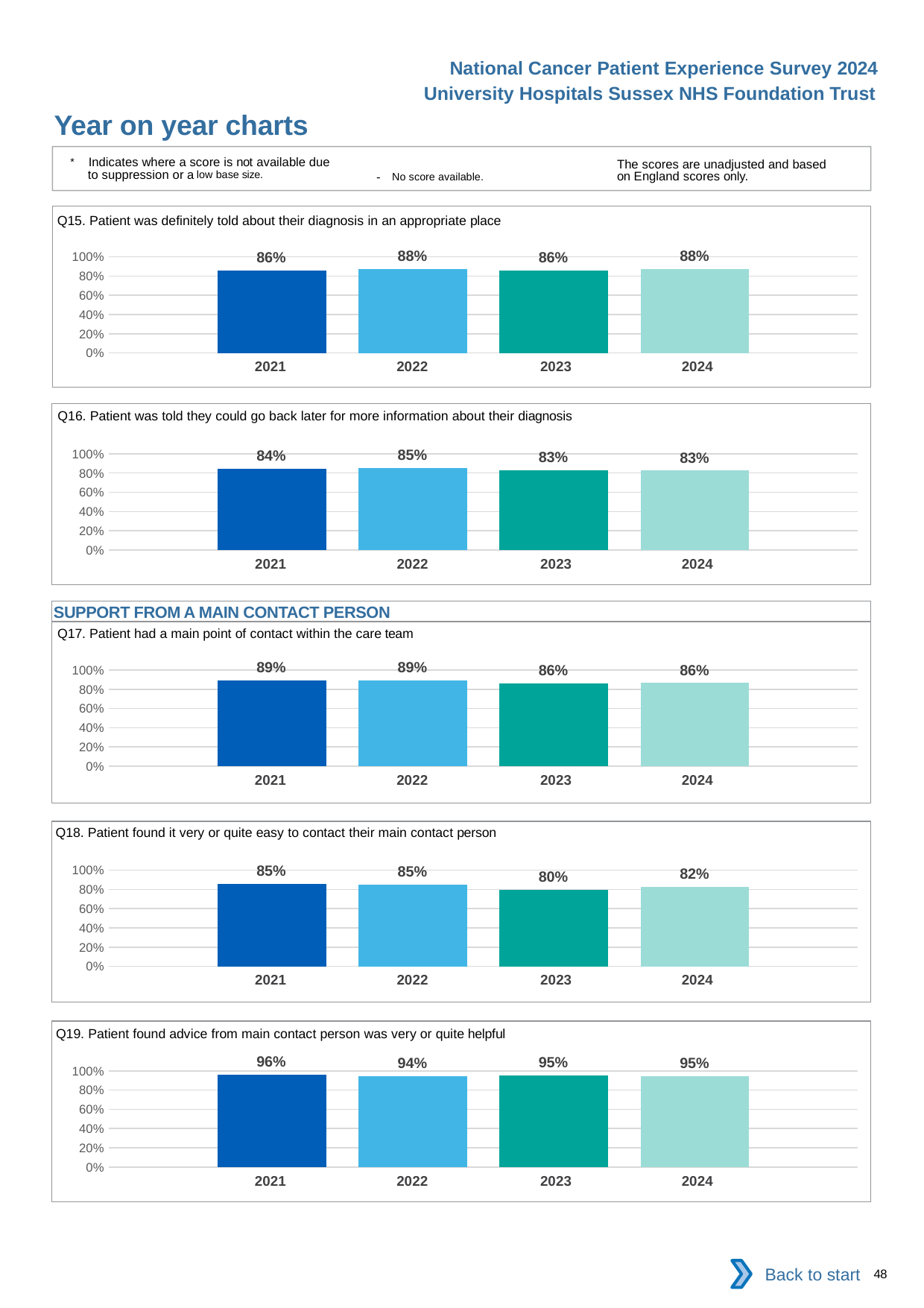
In the Q19 chart, which is larger, the value for 2022 or the value for 2023? 2023 In the Q18 chart (patient found it very or quite easy to contact their main contact person), which year has the lowest value? 2023 In the Q19 chart, what is the difference between the 2021 value and the 2022 value? 2 percentage points How many years are shown on the x axis of the Q15 chart? 4 In the Q15 chart (patient was definitely told about their diagnosis in an appropriate place), what is the value for 2022? 88% In the Q17 chart (patient had a main point of contact within the care team), what is the difference between the 2021 value and the 2024 value? 3 percentage points In the Q16 chart, what is the value for 2024? 83% What kind of chart is used for Q17? Bar chart In the Q18 chart, what is the value for 2024? 82% In the Q19 chart (patient found advice from main contact person was very or quite helpful), which year has the highest value? 2021 In the Q17 chart, what is the value for 2023? 86% In the Q16 chart (patient was told they could go back later for more information about their diagnosis), which year has the highest value? 2022